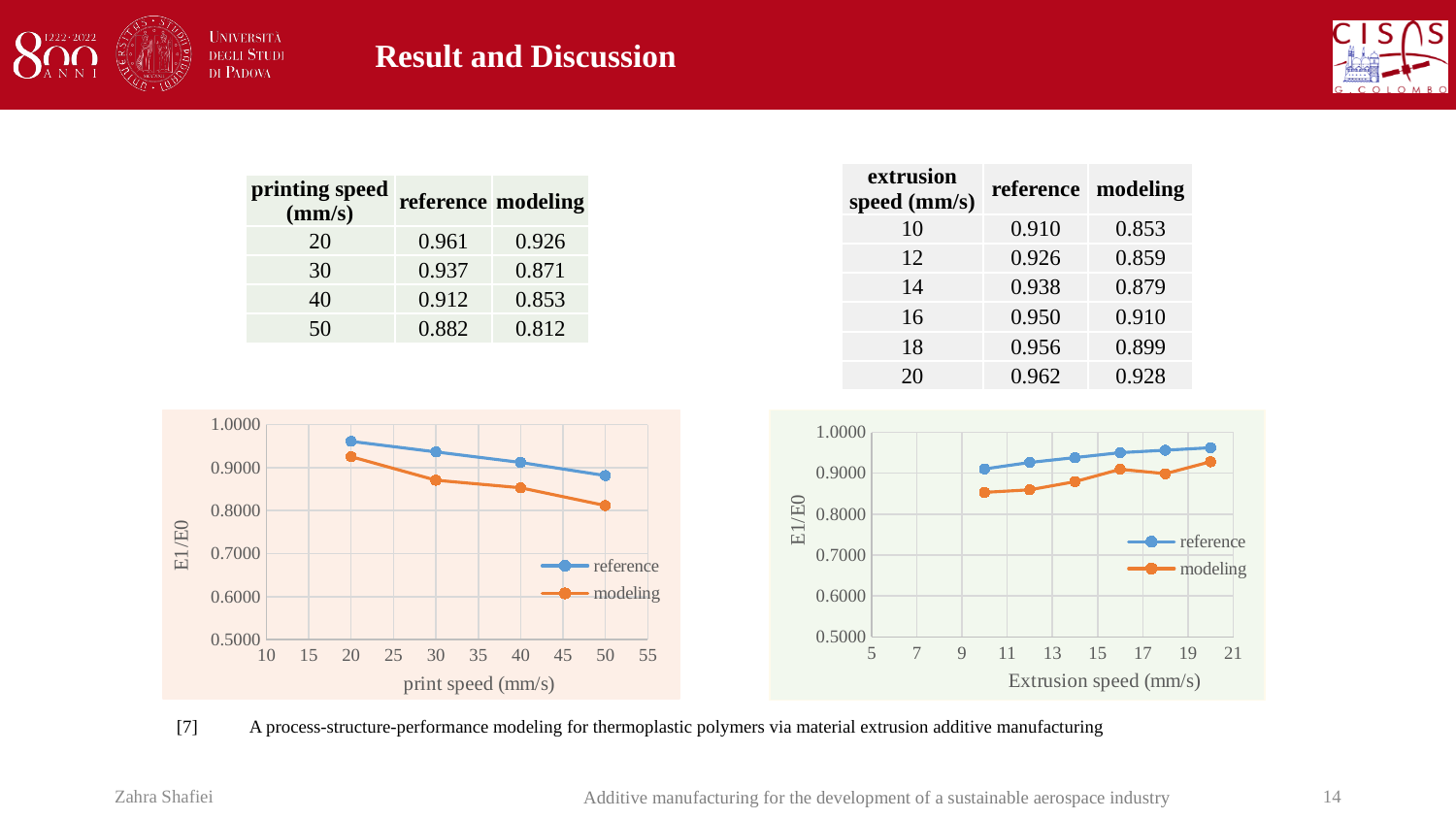
In the left chart (print speed), do the reference values rise or fall as print speed increases? fall What kind of chart is the left chart with x axis 'print speed (mm/s)'? line chart In the left chart (print speed), how many data points does the reference series have? 4 In the left chart (print speed), which series is higher at 30 mm/s, reference or modeling? reference What is the y-axis label of the right chart (extrusion speed)? E1/E0 In the right chart (extrusion speed), at which extrusion speed is the reference value highest? 20 In the left chart (print speed), is the modeling value at 50 mm/s greater or less than 0.9000? less In the left chart (print speed), at which print speed is the modeling value lowest? 50 In the right chart (extrusion speed), do the reference values rise or fall as extrusion speed increases? rise In the left chart (print speed), how many series does the legend list? 2 In the right chart (extrusion speed), how many data points does the modeling series have? 6 In the right chart (extrusion speed), is the modeling value at 10 mm/s greater or less than 0.9000? less